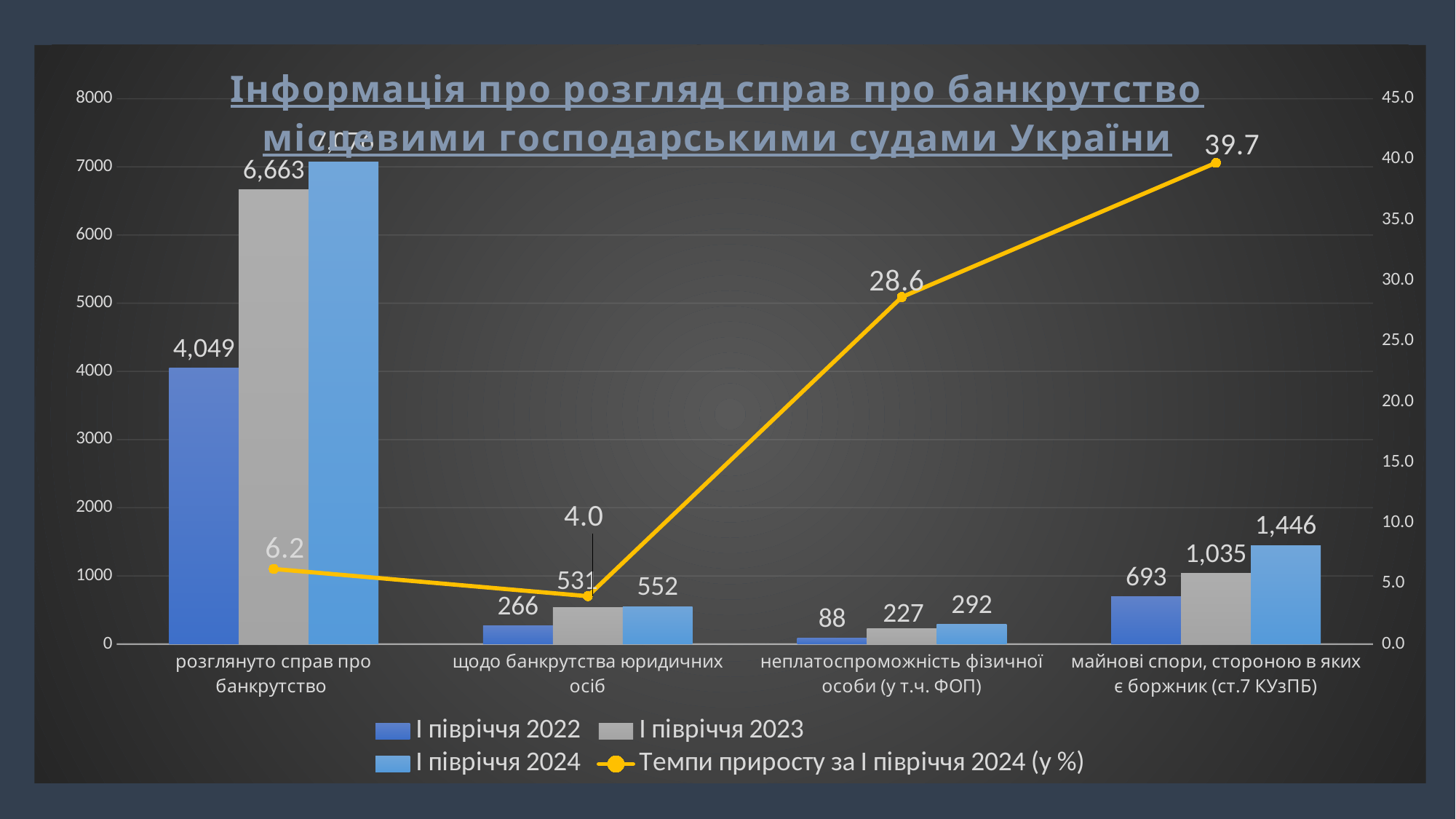
How many categories are shown on the x axis? 4 By how much does the «І півріччя 2024» value exceed the «І півріччя 2022» value for «майнові спори, стороною в яких є боржник (ст.7 КУзПБ)»? 753 What is the value for «І півріччя 2023» in the category «майнові спори, стороною в яких є боржник (ст.7 КУзПБ)»? 1,035 For «щодо банкрутства юридичних осіб», which is larger: the «І півріччя 2023» value or the «І півріччя 2024» value? І півріччя 2024 What is the value for «І півріччя 2022» in the category «неплатоспроможність фізичної особи (у т.ч. ФОП)»? 88 What is the difference between the «І півріччя 2023» and «І півріччя 2022» values for «розглянуто справ про банкрутство»? 2,614 What is the value for «І півріччя 2022» in the category «розглянуто справ про банкрутство»? 4,049 What kind of chart is shown on the slide? A bar chart combined with a line chart Which category has the lowest growth rate on the line series? щодо банкрутства юридичних осіб How many series does the legend list? 4 Which category has the highest growth rate on the line series? майнові спори, стороною в яких є боржник (ст.7 КУзПБ) What is the growth rate («Темпи приросту за І півріччя 2024») for the category «неплатоспроможність фізичної особи (у т.ч. ФОП)»? 28.6